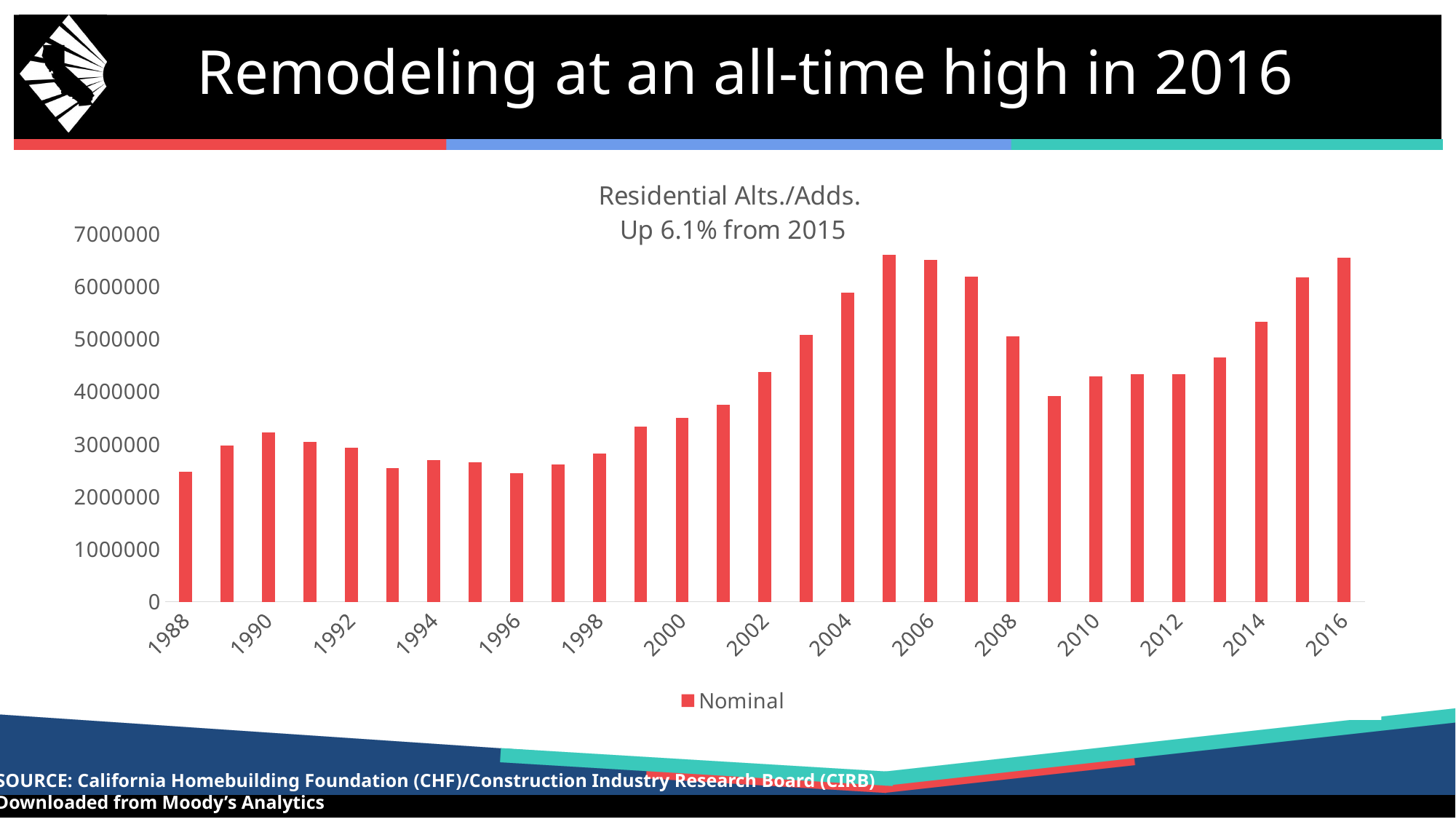
Which year has the larger value, 2015 or 2016? 2016 What kind of chart is shown on the slide? bar chart How many years (bars) are plotted in the chart? 29 What is the title of the chart? Residential Alts./Adds. Up 6.1% from 2015 Is the value for 2016 greater or less than 6000000? greater Which year has the larger value, 2005 or 2009? 2005 Is the value for 2014 greater or less than 5000000? greater What is the name of the series shown in the legend? Nominal Is the value for 1988 greater or less than 3000000? less How many series does the legend list? 1 Do the values rise or fall from 2005 to 2009? fall